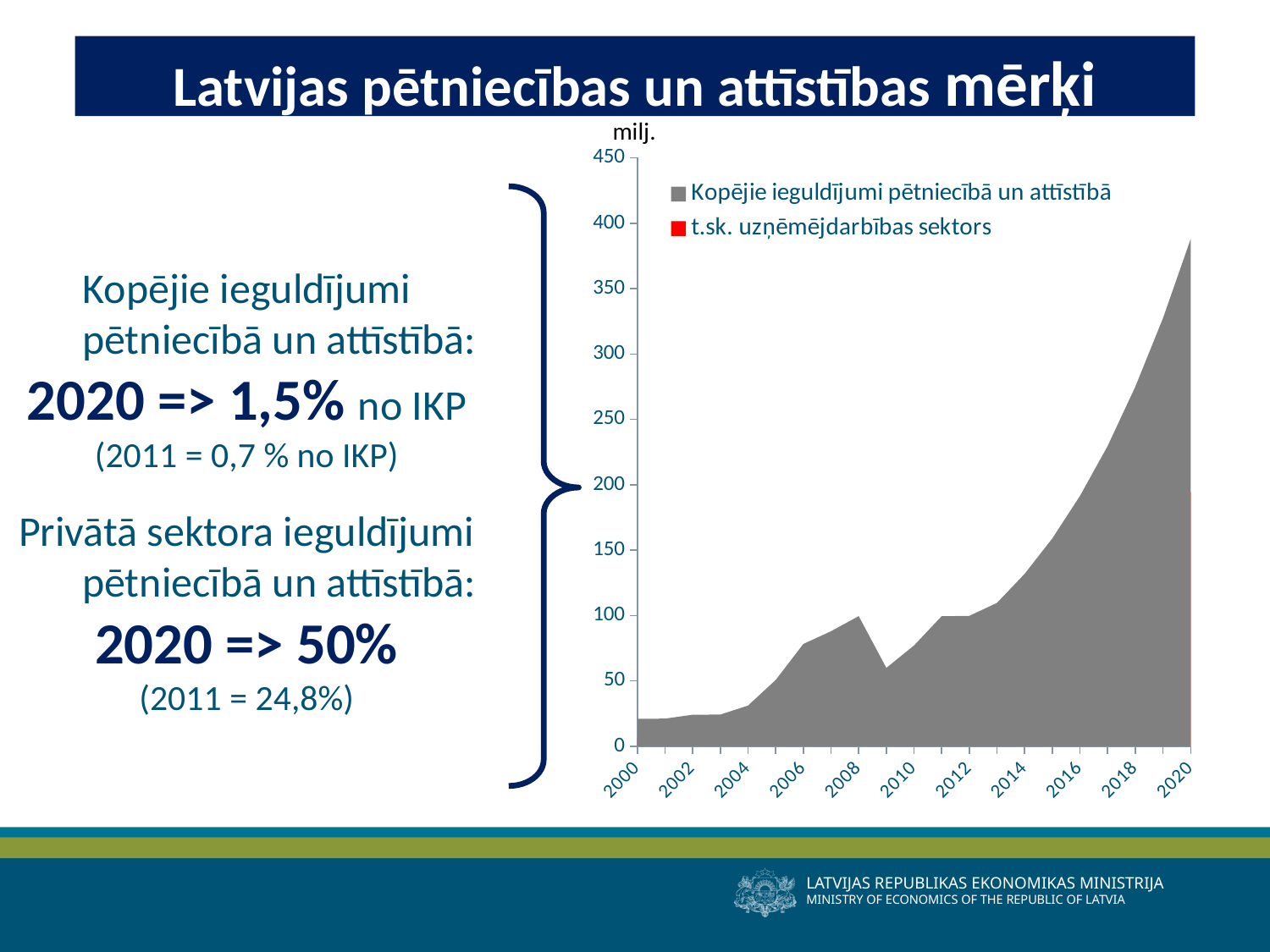
Is the value for 2018 greater or less than 200? greater Is the value for 2020 greater or less than 350? greater What kind of chart is shown on the slide? area chart Is the value for 2006 greater or less than 50? greater What is the first legend entry of the chart? Kopējie ieguldījumi pētniecībā un attīstībā Which year has the larger value, 2008 or 2009? 2008 How many series does the chart legend list? 2 What unit label is shown above the vertical axis of the chart? milj. Which year has the highest value in the chart? 2020 Overall, do the values rise or fall from 2000 to 2020? rise